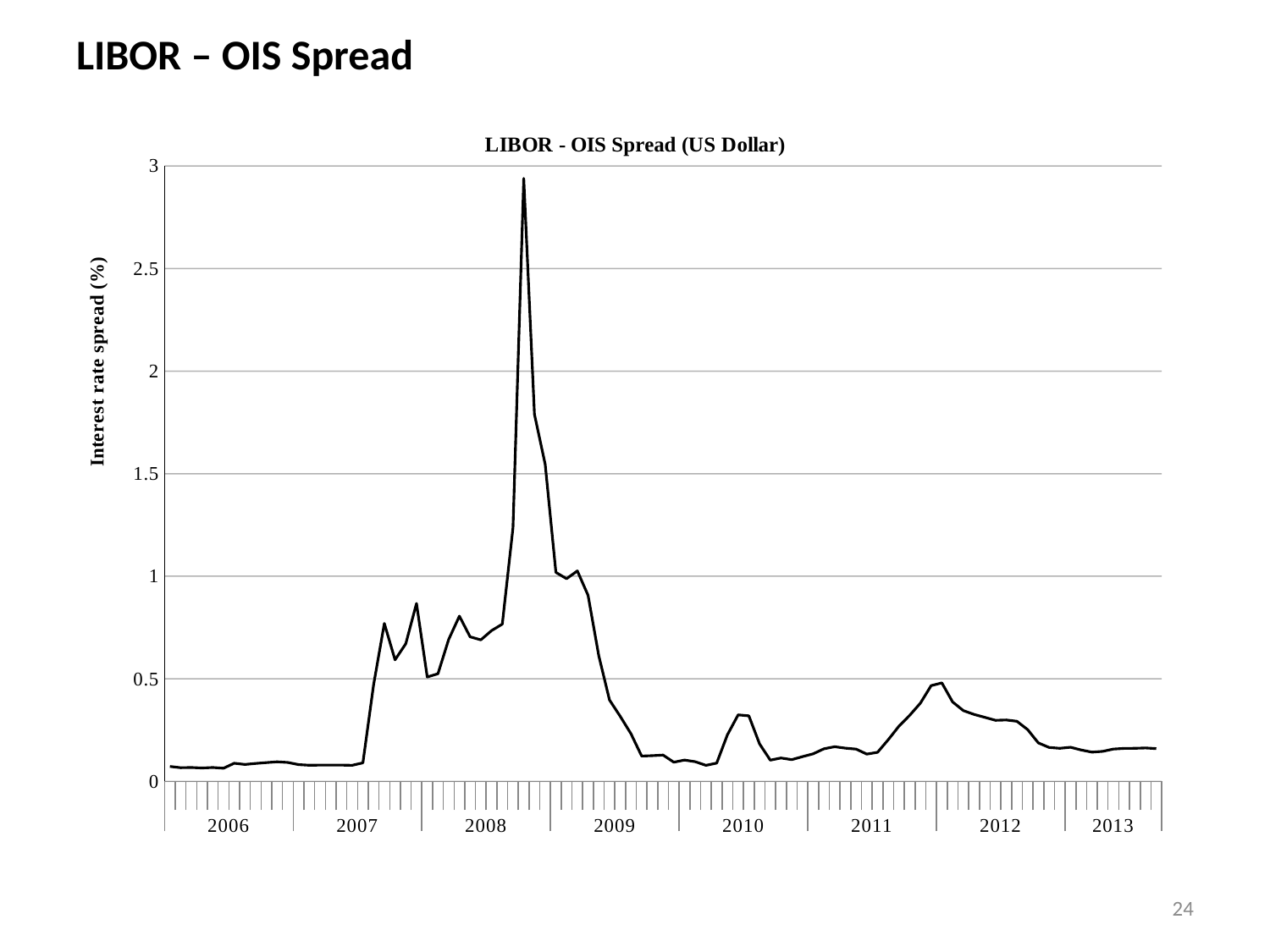
Is the spread at the end of 2013 greater or less than 0.5? less What is the label on the vertical axis of the chart? Interest rate spread (%) Does the spread rise or fall from the start of 2009 to the end of 2009? fall What kind of chart is shown on the slide? line chart Is the peak value of the spread in 2008 greater or less than 2.5? greater What is the title of the chart? LIBOR - OIS Spread (US Dollar) Does the spread rise or fall from the start of 2012 to the end of 2012? fall How many year labels are shown on the horizontal axis? 8 Is the highest spread reached in 2010 greater or less than 0.5? less In which year does the LIBOR - OIS spread reach its highest value? 2008